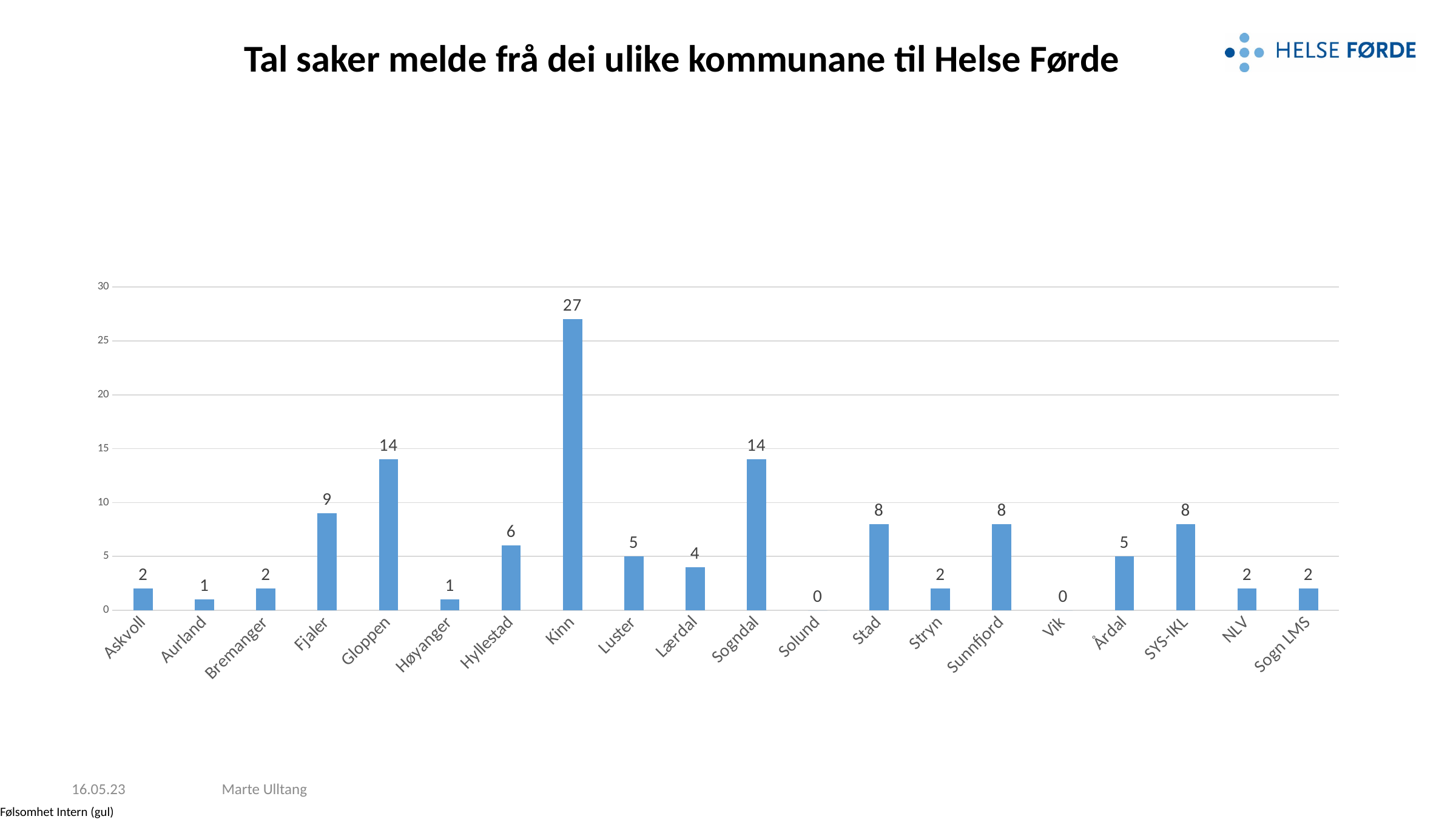
Is the value for Kinn greater or less than 25? greater Which category has the highest value? Kinn What is the value for Kinn? 27 How many categories are shown on the x axis? 20 What is the difference between the values for Kinn and Gloppen? 13 Which is larger, the value for Sogndal or the value for Sunnfjord? Sogndal What kind of chart is shown on the slide? bar chart What is the difference between the values for Stad and Stryn? 6 What is the value for Hyllestad? 6 What is the title of the chart? Tal saker melde frå dei ulike kommunane til Helse Førde What is the value for Lærdal? 4 What is the value for Fjaler? 9